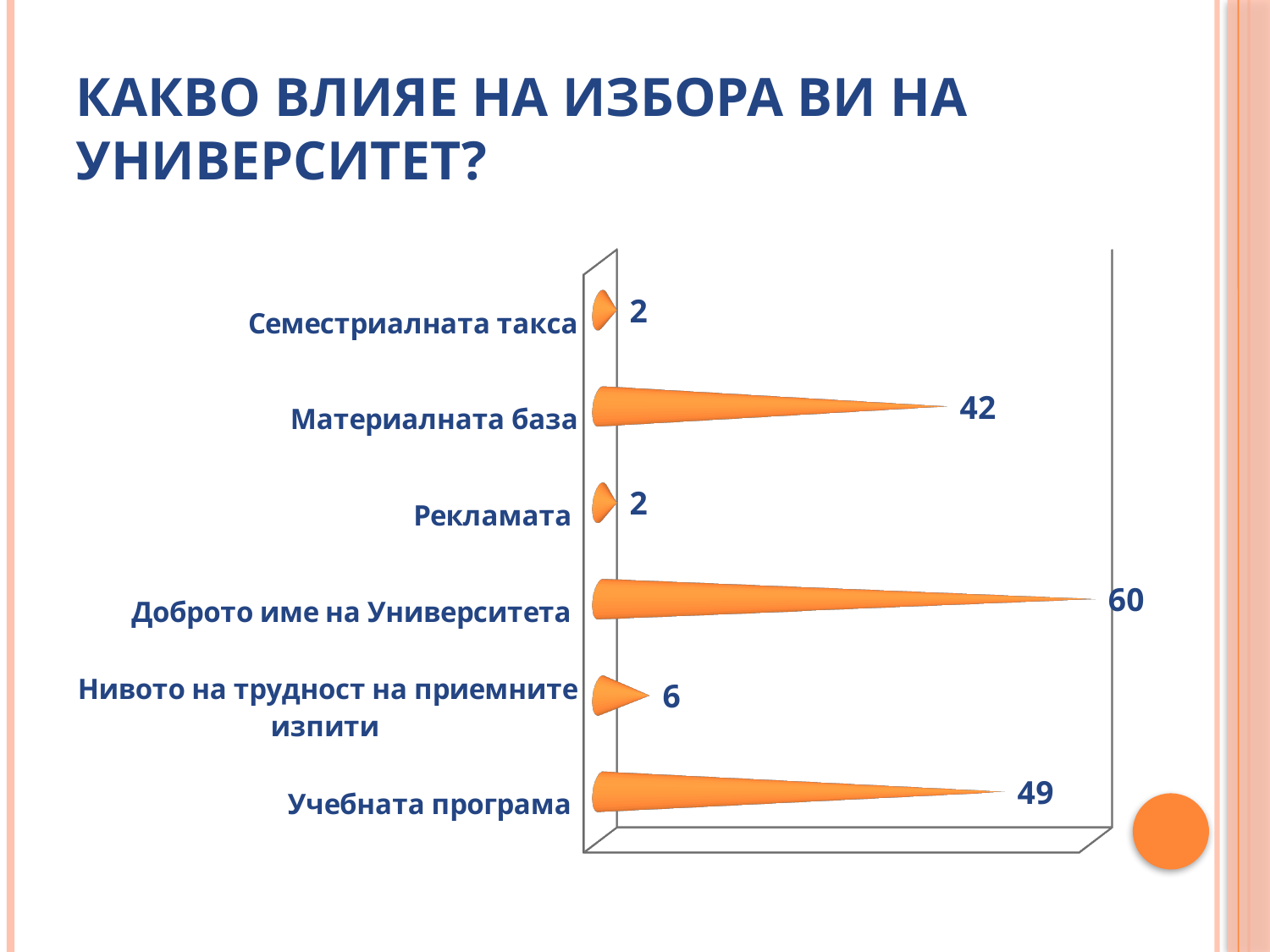
What is the difference between the values for "Доброто име на Университета" and "Учебната програма"? 11 What value is shown for "Рекламата"? 2 What is the difference between the values for "Учебната програма" and "Материалната база"? 7 What value is shown for "Материалната база"? 42 How many categories are shown in the chart? 6 What value is shown for "Учебната програма"? 49 What value is shown for "Нивото на трудност на приемните изпити"? 6 What kind of chart is shown on the slide? Bar chart What value is shown for "Доброто име на Университета"? 60 Which category has the highest value? Доброто име на Университета Which is larger, the value for "Материалната база" or the value for "Учебната програма"? Учебната програма Which is larger, the value for "Нивото на трудност на приемните изпити" or the value for "Семестриалната такса"? Нивото на трудност на приемните изпити